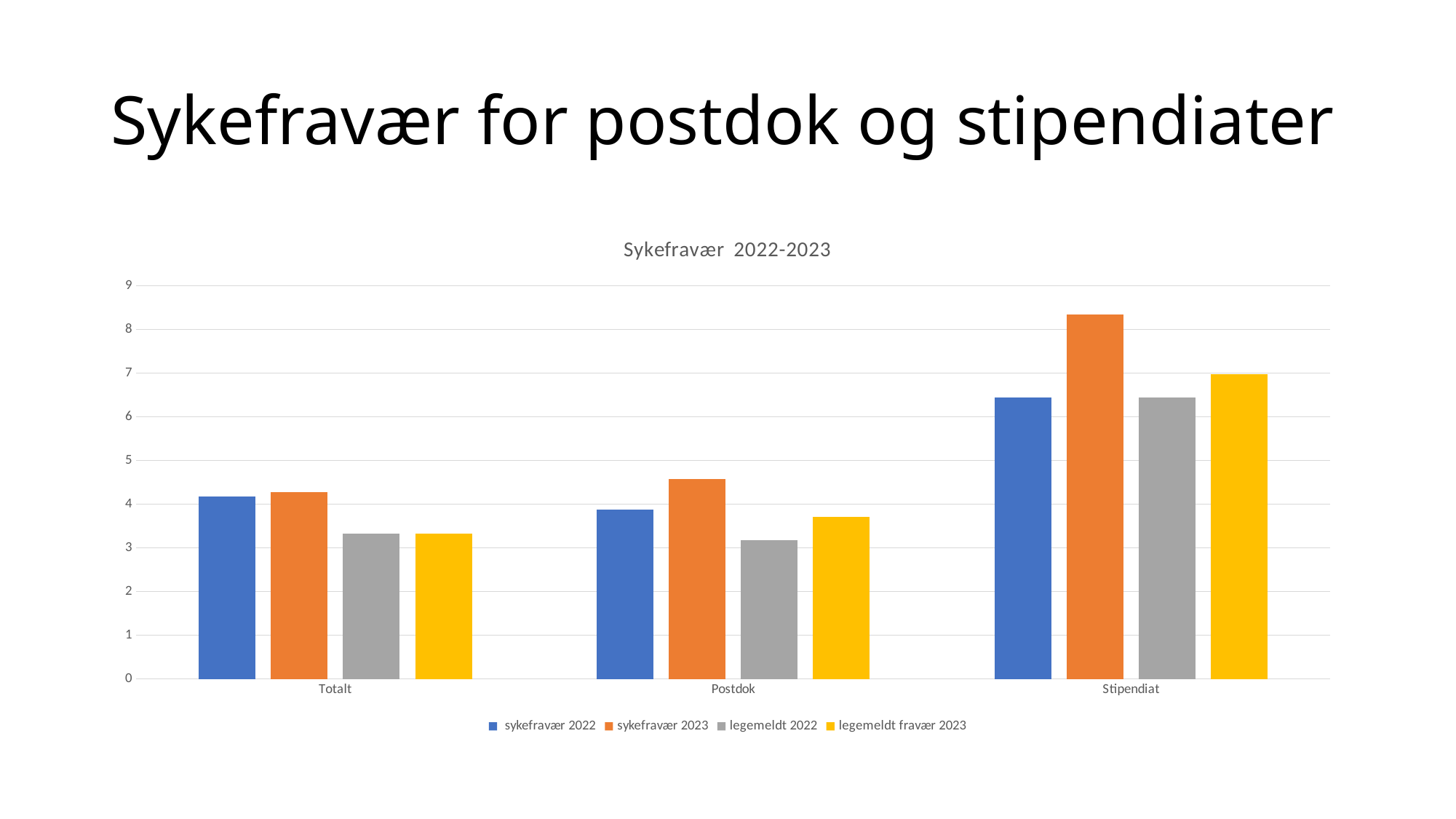
How many series does the legend list? 4 Which category has the highest value for sykefravær 2023? Stipendiat For Postdok, which is larger: sykefravær 2022 or sykefravær 2023? sykefravær 2023 For Stipendiat, which is larger: legemeldt 2022 or legemeldt fravær 2023? legemeldt fravær 2023 How many categories are shown on the x axis? 3 What is the title of the chart? Sykefravær 2022-2023 Is the value for legemeldt fravær 2023 for Stipendiat greater or less than 6? greater Is the value for sykefravær 2022 for Totalt greater or less than 4? greater Is the value for sykefravær 2023 for Stipendiat greater or less than 8? greater What kind of chart is shown on the slide? bar chart Do the values for sykefravær 2023 rise or fall from Totalt to Stipendiat along the x axis? rise Which category has the lowest value for sykefravær 2022? Postdok